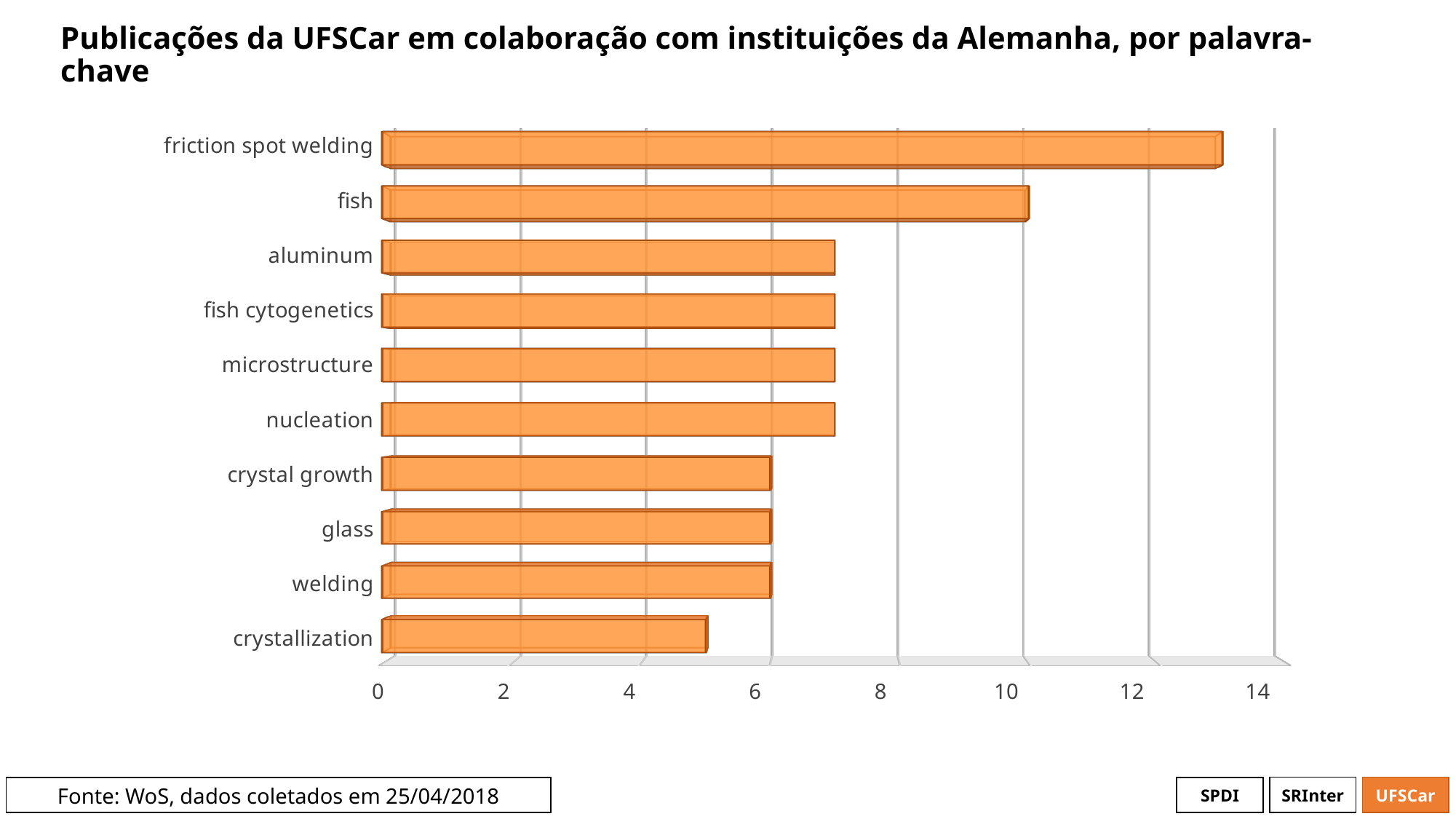
What kind of chart is shown on the slide? bar chart Which has more publications, welding or friction spot welding? friction spot welding What is the title of the chart? Publicações da UFSCar em colaboração com instituições da Alemanha, por palavra-chave Is the value for fish greater or less than 8? greater How many keywords (categories) are shown in the chart? 10 Which has more publications, fish or aluminum? fish Is the value for crystal growth greater or less than 8? less Is the value for aluminum greater or less than 6? greater Which keyword has the lowest number of publications? crystallization Which keyword has the highest number of publications? friction spot welding